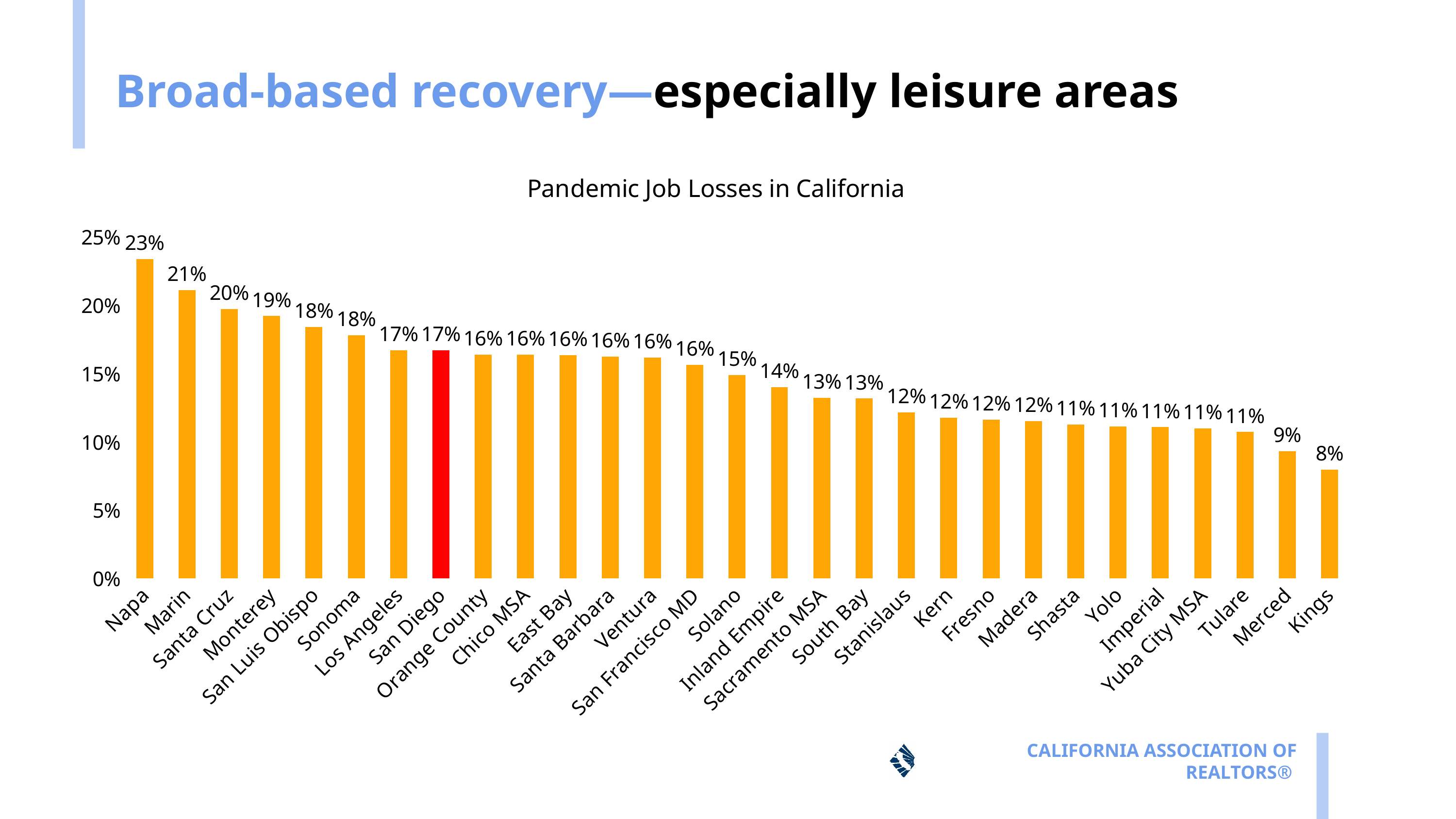
What type of chart is shown on the slide? bar chart What is the difference between the values for Napa and Kings? 15% Which bar is highlighted in red? San Diego What is the chart title? Pandemic Job Losses in California What is the value for San Diego? 17% Which is larger, the value for Marin or the value for Solano? Marin Which area has the highest pandemic job losses? Napa Which area has the lowest pandemic job losses? Kings What is the value for Inland Empire? 14% How many areas are shown on the chart? 29 Do the values rise or fall moving from left to right along the x axis? fall What is the value for Napa? 23%